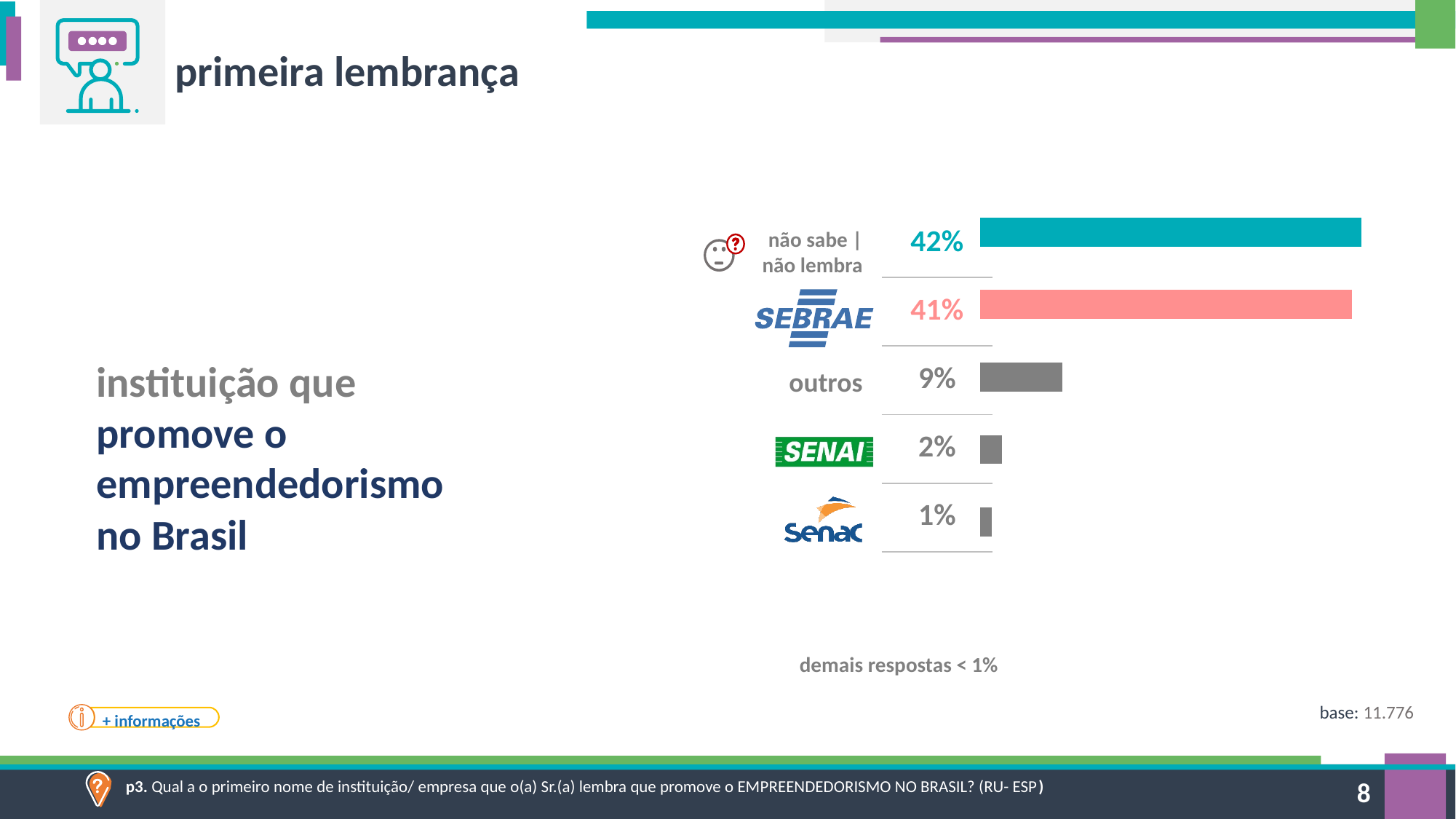
What is the difference in percentage points between 'não sabe | não lembra' and SEBRAE? 1 percentage point How many categories are shown in the chart? 5 What type of chart is shown on the slide? Bar chart What is the difference in percentage points between SEBRAE and 'outros'? 32 percentage points What percentage of respondents answered 'não sabe | não lembra'? 42% Which category has the highest value in the chart? não sabe | não lembra What percentage of respondents named SEBRAE as the institution that promotes entrepreneurship in Brazil? 41% Which has a larger value, SENAI or Senac? SENAI What percentage is shown for Senac? 1% Which category has the lowest value in the chart? Senac What percentage is shown for SENAI? 2% What is the value shown for 'outros'? 9%